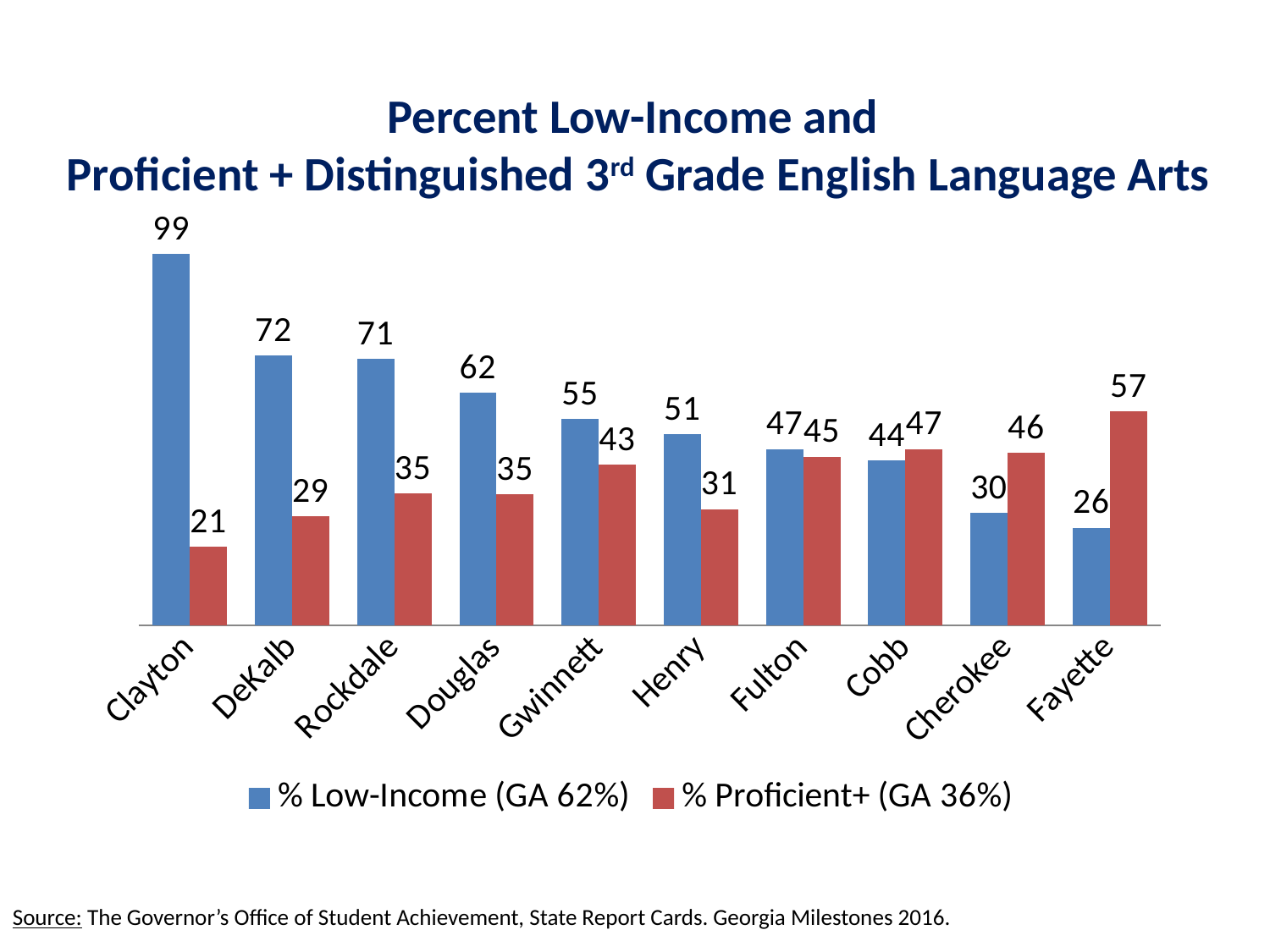
Do the % Low-Income values generally rise or fall from Clayton to Fayette? Fall How many counties are shown on the x axis? 10 What is the % Proficient+ value for Fayette? 57 How many series does the legend list? 2 What is the % Low-Income value for Clayton? 99 Which county has the highest % Low-Income value? Clayton Which is larger for Cobb: % Low-Income or % Proficient+? % Proficient+ What kind of chart is shown on the slide? Bar chart Which county has the lowest % Proficient+ value? Clayton What Georgia statewide value is given in the legend for % Proficient+? 36% What is the % Proficient+ value for Gwinnett? 43 What is the difference between the % Low-Income and % Proficient+ values for DeKalb? 43